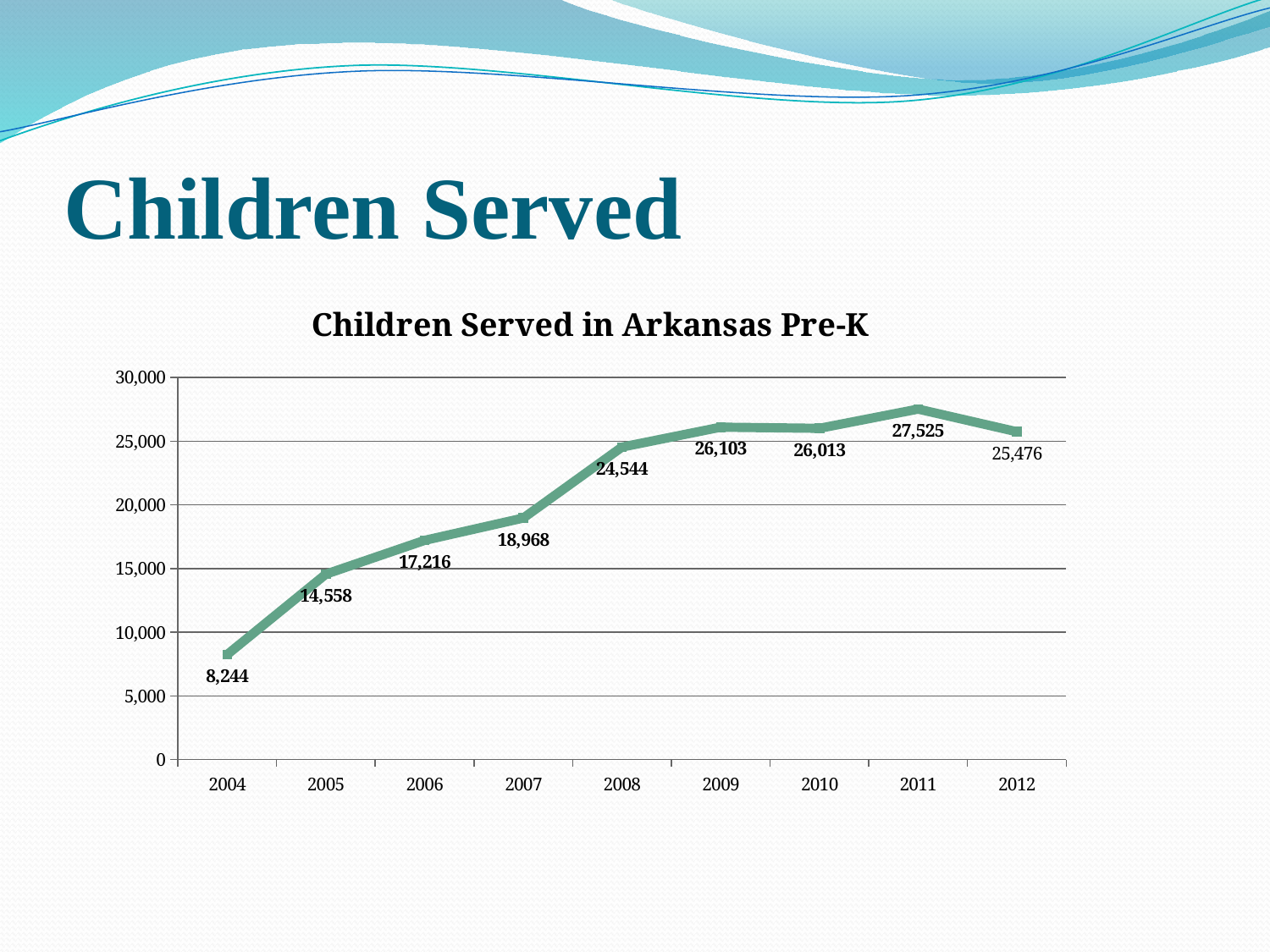
What is the value for 2008? 24,544 How many years are plotted on the chart? 9 Is the value for 2007 greater or less than 20,000? less What kind of chart is shown? line chart What is the difference between the values for 2005 and 2004? 6,314 What is the value for 2004? 8,244 Which year has the lowest value? 2004 Which is larger, the value for 2009 or the value for 2010? 2009 What is the difference between the values for 2011 and 2012? 2,049 Which year has the highest value? 2011 What is the title of the chart? Children Served in Arkansas Pre-K What is the value for 2012? 25,476